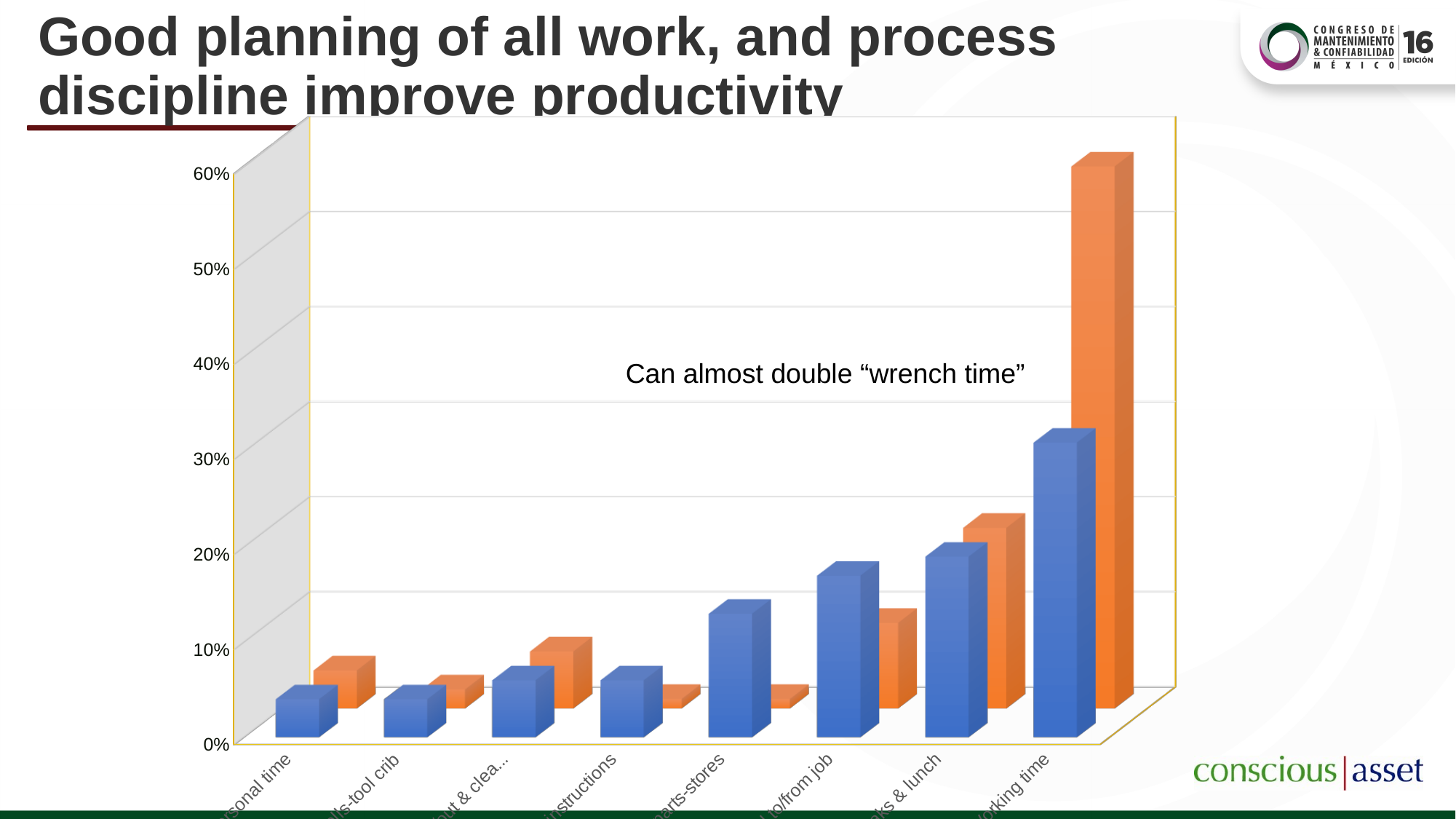
How many bar series are plotted in the chart? 2 Is the blue bar for the rightmost category (…orking time) greater or less than 40%? less In the category labelled …to/from job, which bar is taller, the blue one or the orange one? the blue one Do the blue bars generally rise or fall from left to right along the x axis? rise Which category has the tallest orange bar? the rightmost category (…orking time) Is the orange bar for the rightmost category (…orking time) greater or less than 50%? greater What text annotation is printed inside the chart area? Can almost double "wrench time" Is the orange bar for the category labelled …instructions greater or less than 10%? less In the rightmost category (…orking time), which bar is taller, the blue one or the orange one? the orange one How many categories are plotted along the x axis of the chart? 8 What kind of chart is shown on the slide? bar chart